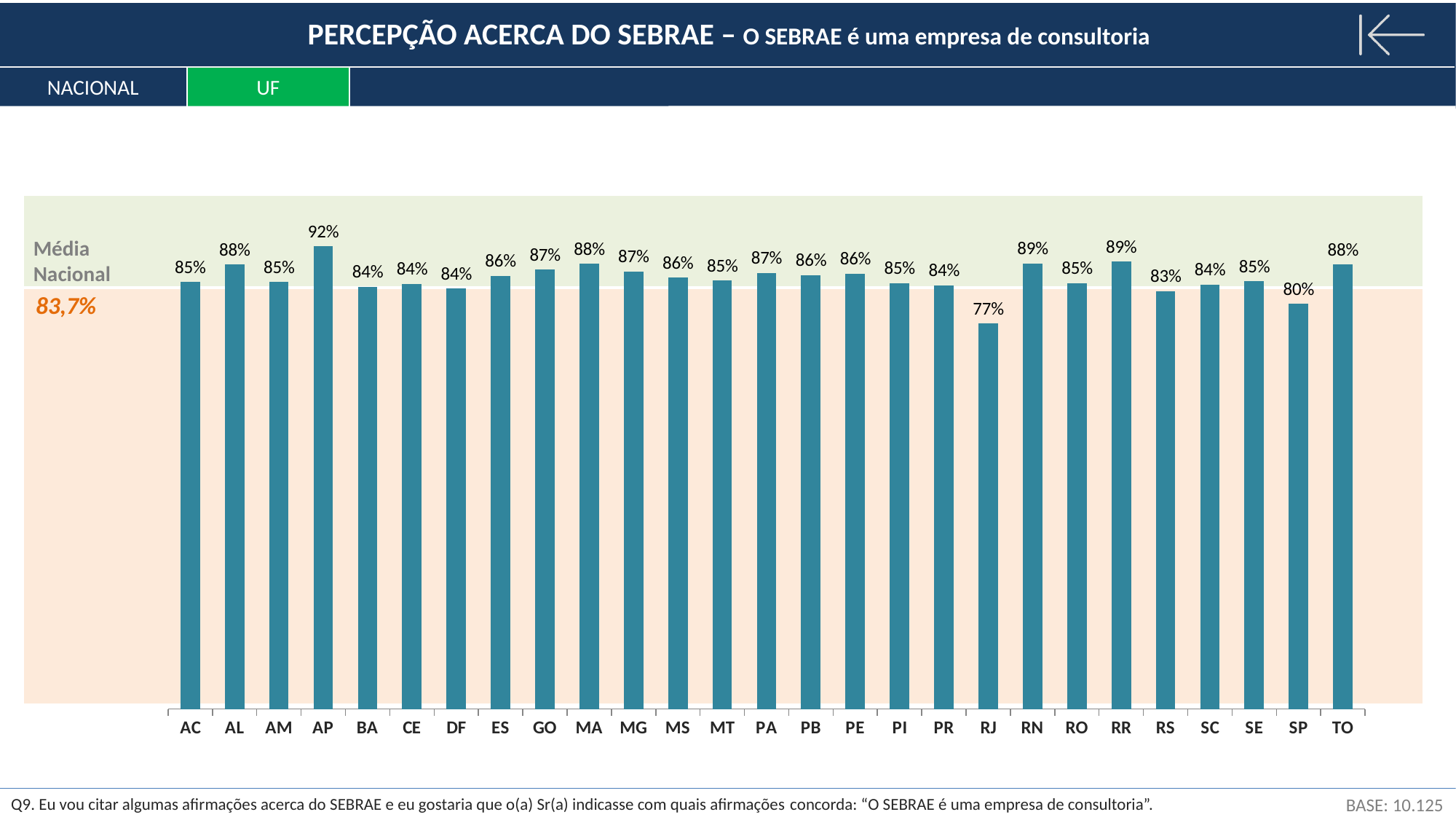
How many states (UF) are shown on the x axis? 27 What is the Média Nacional value shown on the chart? 83,7% What is the value for SP? 80% Which is larger, the value for RS or the value for RR? RR Which state has the highest value? AP What is the value for RJ? 77% What is the difference between the values for AP and RJ? 15% What kind of chart is shown on the slide? bar chart Which state has the lowest value? RJ What is the difference between the values for TO and SP? 8% What is the value for AP? 92% What is the value for RN? 89%